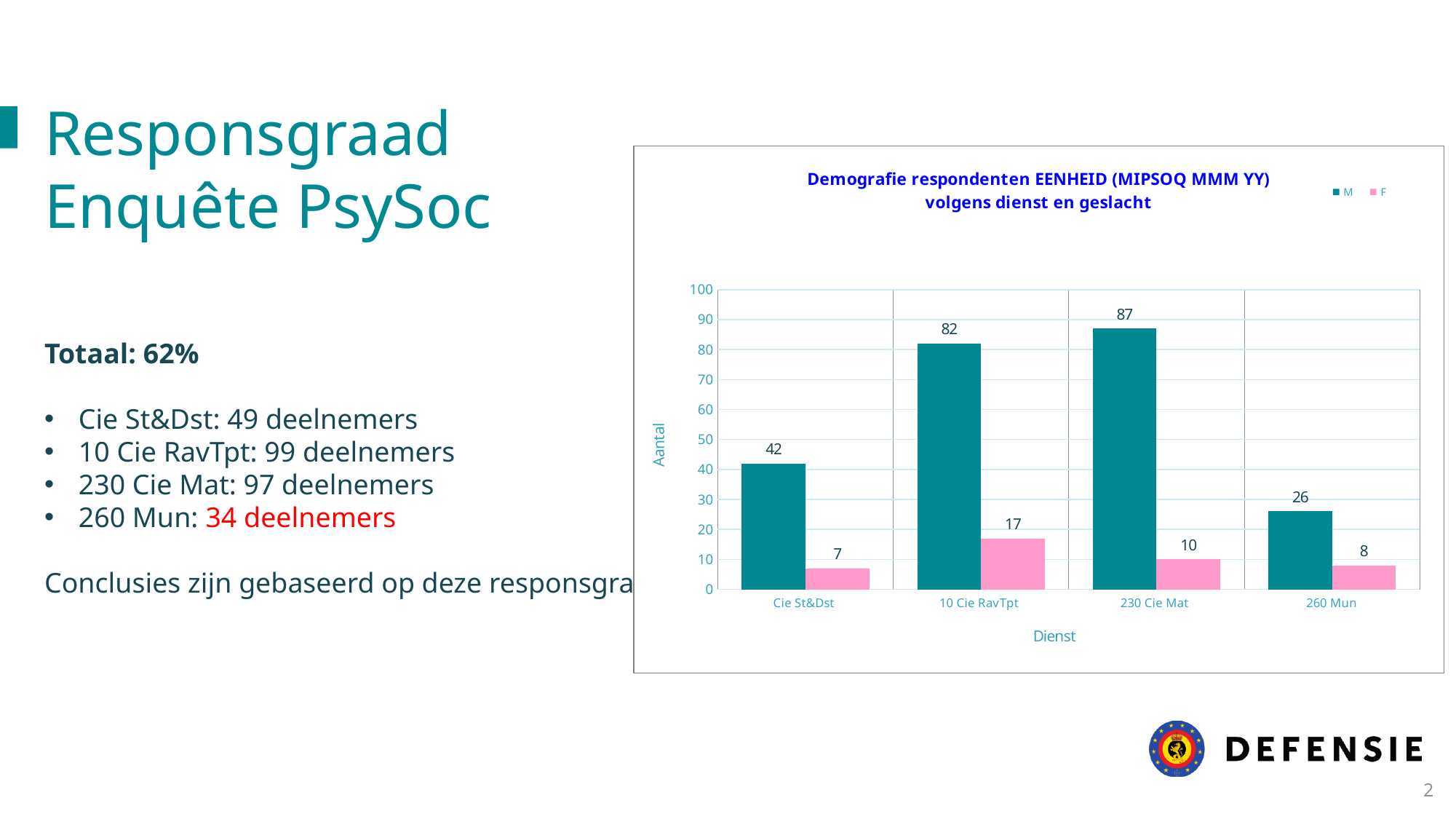
How many series does the legend list? 2 Which category has the highest value for M? 230 Cie Mat Which category has the lowest value for F? Cie St&Dst What is the value for M in the 260 Mun category? 26 What is the difference between the M and F values for Cie St&Dst? 35 How many categories are shown on the x axis? 4 What is the label of the y axis? Aantal Which is larger: the F value for 10 Cie RavTpt or the F value for 260 Mun? 10 Cie RavTpt What is the label of the x axis? Dienst What kind of chart is shown on the slide? bar chart What is the value for M in the 10 Cie RavTpt category? 82 What is the value for F in the 230 Cie Mat category? 10